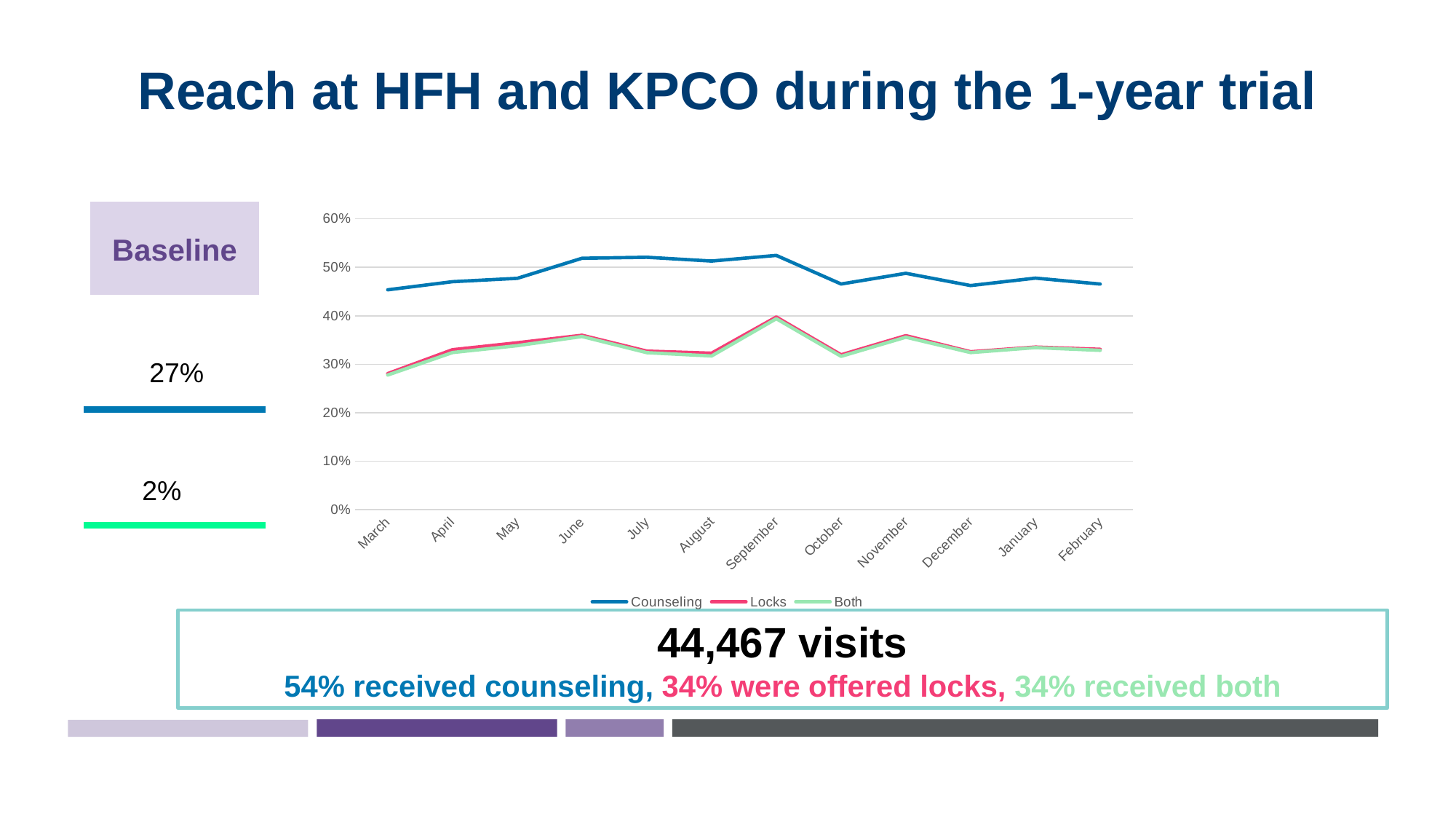
How many series does the chart's legend list? 3 How many months are plotted along the x axis of the chart? 12 In which month is the Locks series at its lowest value? March Does the Locks series rise or fall from March to June? rise What are the three series named in the chart's legend? Counseling, Locks, Both Is the Counseling value for March greater or less than 50%? less Which series is plotted with the blue line in the chart? Counseling Is the Locks value for March greater or less than 30%? less What kind of chart is shown on the slide? line chart In which month does the Locks series reach its highest value? September Which series has the higher value in September, Counseling or Locks? Counseling Is the Counseling value for June greater or less than 50%? greater